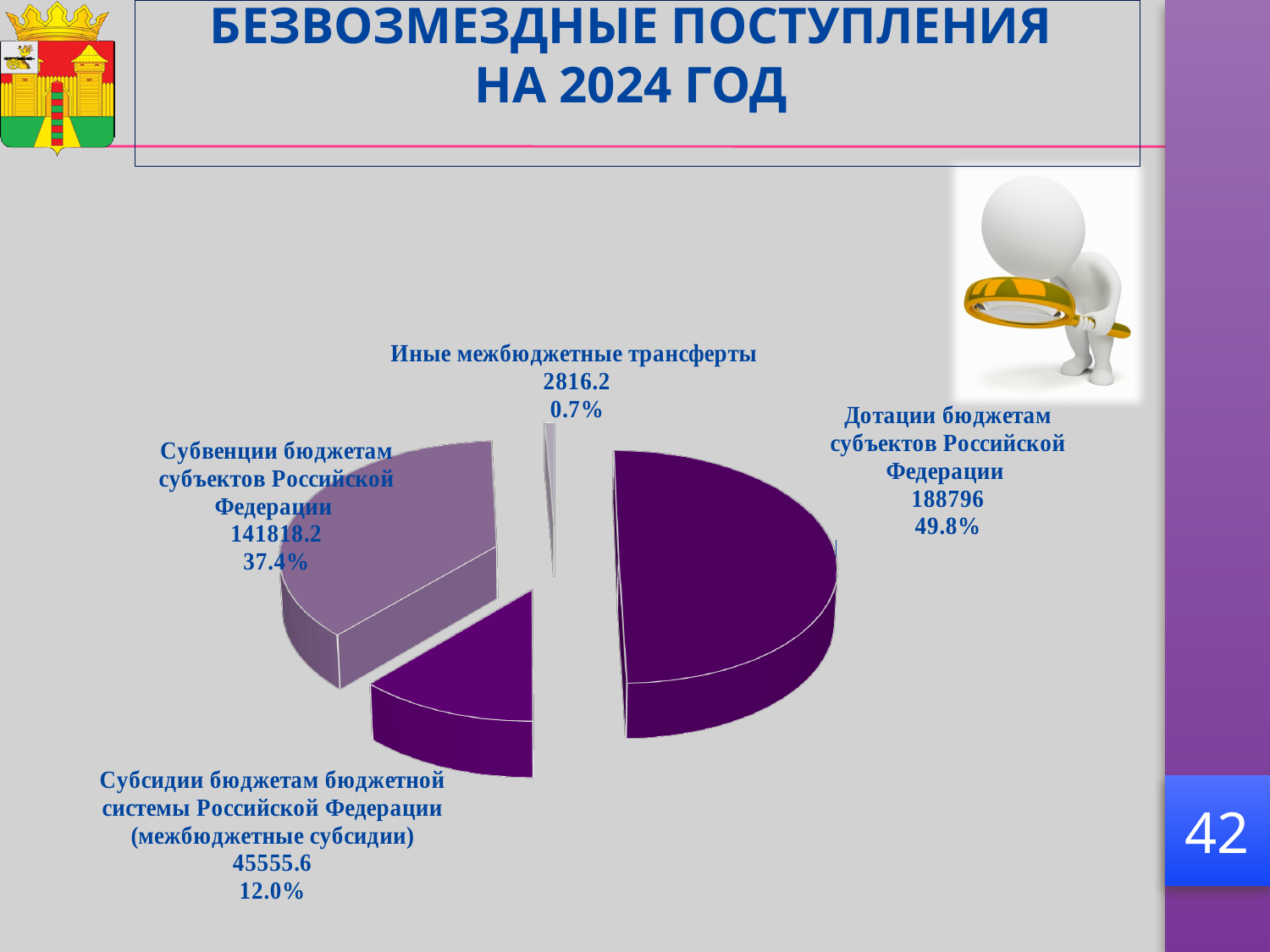
What is the difference between the values for Дотации бюджетам субъектов Российской Федерации and Субвенции бюджетам субъектов Российской Федерации? 46977.8 What share of the pie does Субсидии бюджетам бюджетной системы Российской Федерации (межбюджетные субсидии) represent? 12.0% Which category has the smallest value? Иные межбюджетные трансферты What is the value for Иные межбюджетные трансферты? 2816.2 What is the value for Дотации бюджетам субъектов Российской Федерации? 188796 What is the value for Субвенции бюджетам субъектов Российской Федерации? 141818.2 What is the title of the slide containing the chart? БЕЗВОЗМЕЗДНЫЕ ПОСТУПЛЕНИЯ НА 2024 ГОД Which category has the largest value? Дотации бюджетам субъектов Российской Федерации How many slices does the pie chart have? 4 Which is larger: the value for Субвенции бюджетам субъектов Российской Федерации or the value for Субсидии бюджетам бюджетной системы Российской Федерации (межбюджетные субсидии)? Субвенции бюджетам субъектов Российской Федерации What type of chart is shown on the slide? Pie chart What share of the pie does Дотации бюджетам субъектов Российской Федерации represent? 49.8%